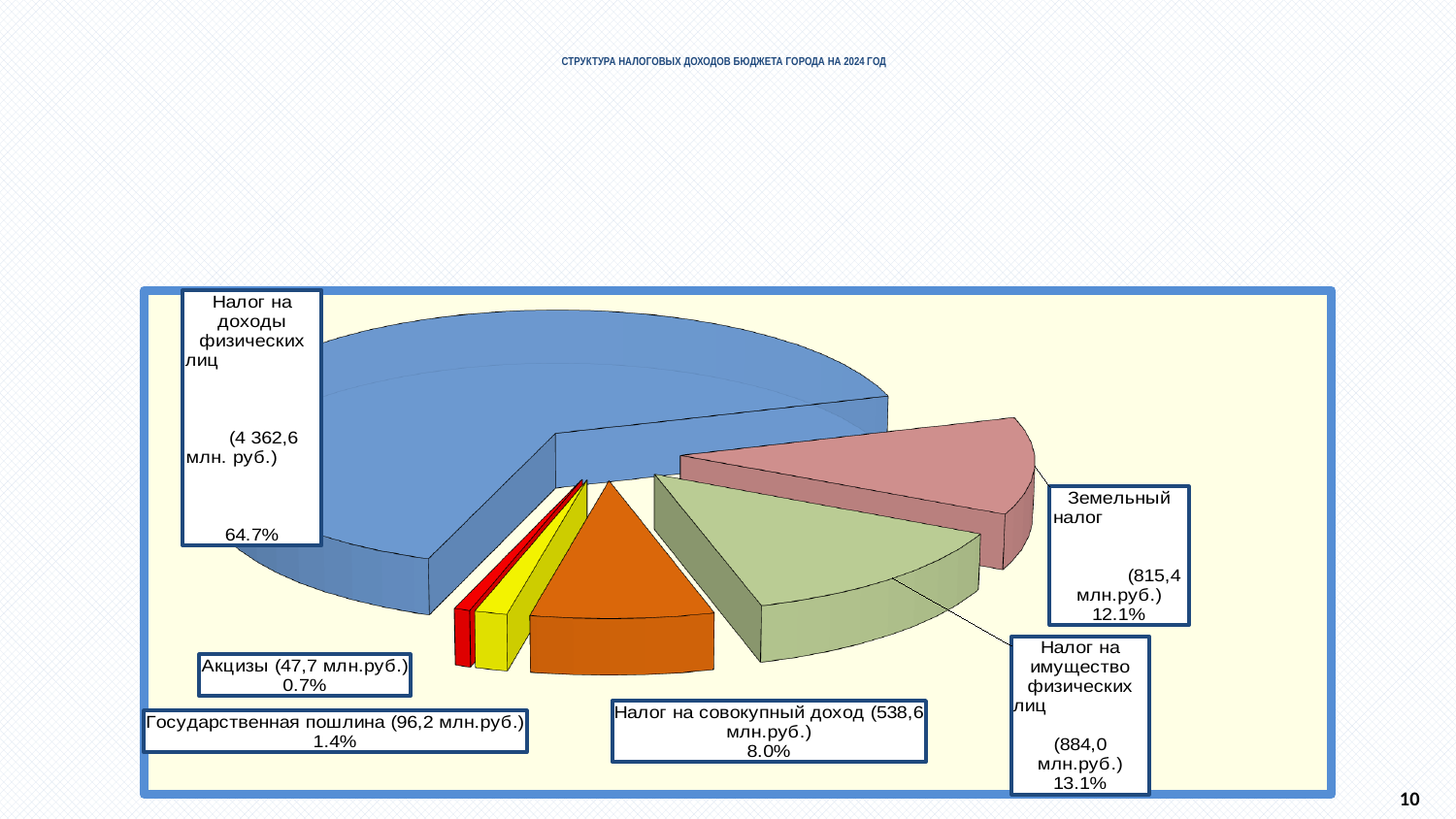
What kind of chart is shown on the slide? pie chart How many slices does the pie chart have? 6 What percentage is shown for "Налог на совокупный доход"? 8.0% Which is larger: the share for "Земельный налог" or the share for "Налог на имущество физических лиц"? Налог на имущество физических лиц What is the value shown for "Акцизы"? 47,7 млн.руб. What is the difference in percentage points between the shares of "Налог на имущество физических лиц" and "Земельный налог"? 1.0 What share of the pie does "Налог на доходы физических лиц" represent? 64.7% Which category has the smallest share of the pie? Акцизы What is the title of the chart? СТРУКТУРА НАЛОГОВЫХ ДОХОДОВ БЮДЖЕТА ГОРОДА НА 2024 ГОД What is the value shown for "Земельный налог"? 815,4 млн.руб. What is the value shown for "Налог на имущество физических лиц"? 884,0 млн.руб. Which category has the largest share of the pie? Налог на доходы физических лиц